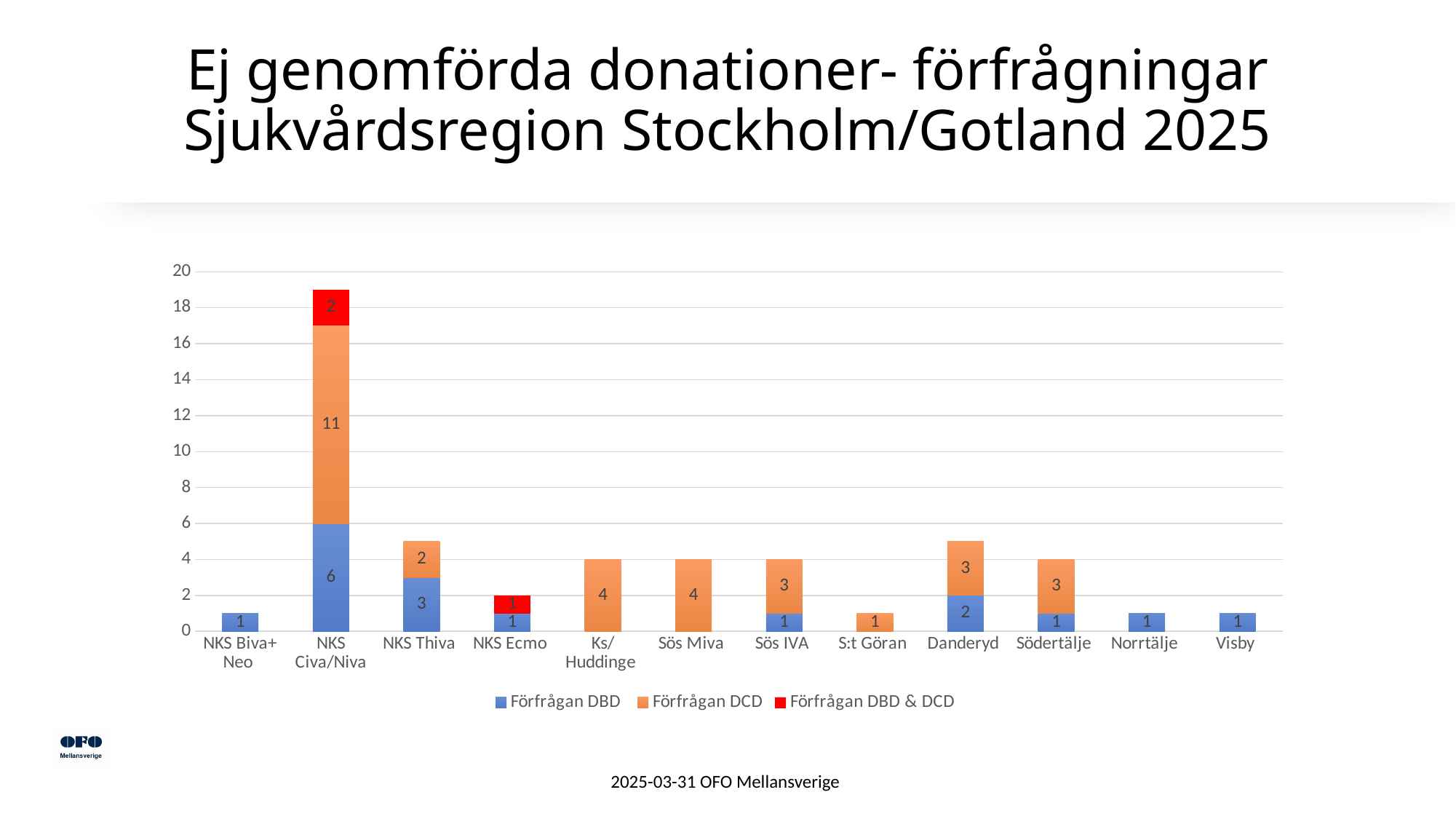
Which category has the highest total stacked bar? NKS Civa/Niva What is the total of the stacked bar for NKS Civa/Niva? 19 How many categories are shown on the x axis? 12 What is the Förfrågan DBD & DCD value for NKS Ecmo? 1 Which is larger, the Förfrågan DBD value for Danderyd or for Sös IVA? Danderyd What is the Förfrågan DCD value for Ks/Huddinge? 4 How many series does the legend list? 3 What is the Förfrågan DBD value for NKS Thiva? 3 What is the Förfrågan DCD value for NKS Civa/Niva? 11 What is the difference between the Förfrågan DCD values for NKS Civa/Niva and Södertälje? 8 What is the total of the stacked bar for Danderyd? 5 What type of chart is shown on the slide? Stacked bar chart